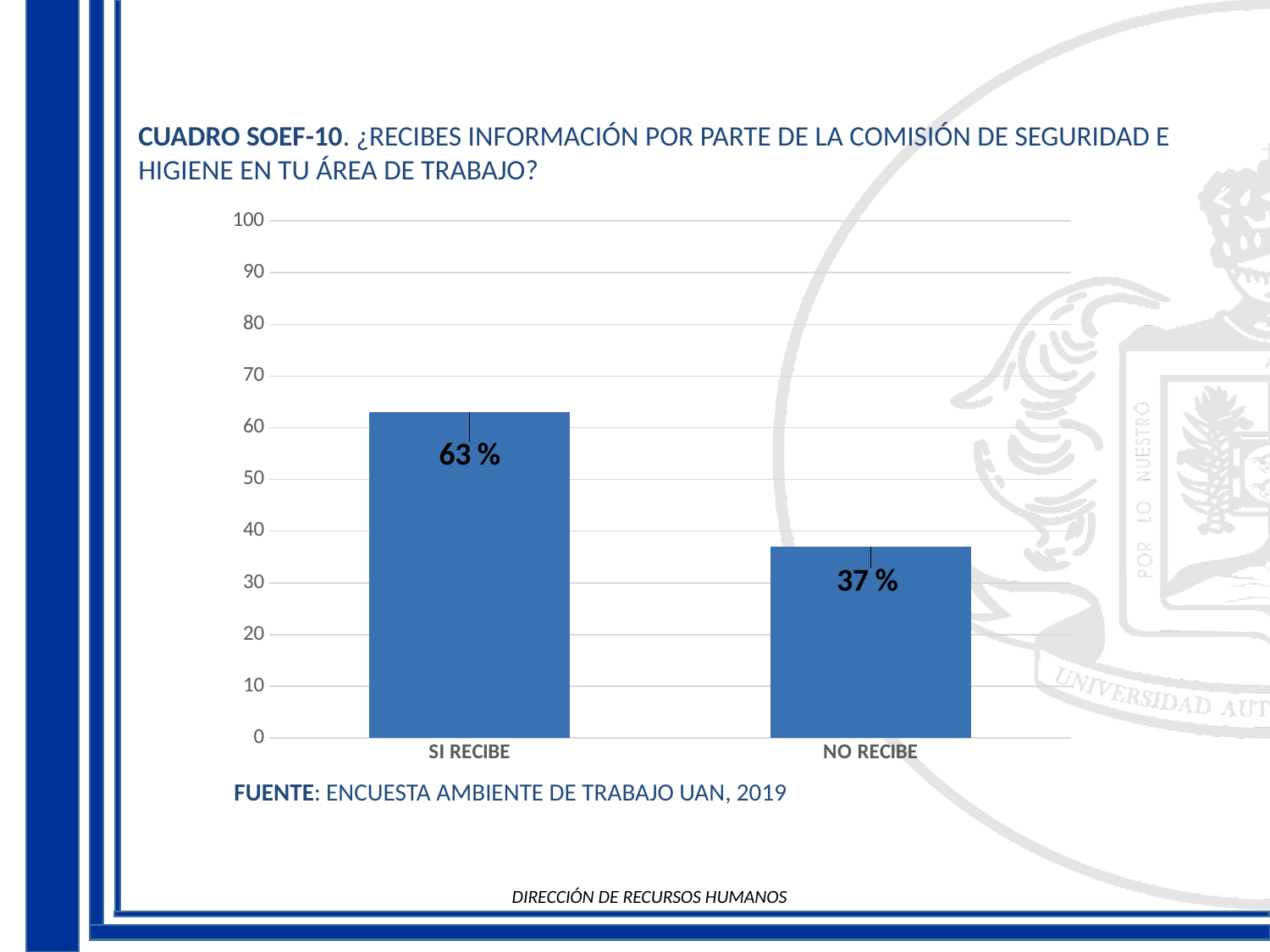
How many categories are shown on the x axis? 2 What is the maximum value shown on the y axis? 100 What is the value for NO RECIBE? 37 % Which category has the lowest value? NO RECIBE What is the difference between the values for SI RECIBE and NO RECIBE? 26 % Is the value for NO RECIBE greater or less than 40? less Is the value for SI RECIBE greater or less than 60? greater Which category has the highest value? SI RECIBE Which is larger, the value for SI RECIBE or the value for NO RECIBE? SI RECIBE What is the value for SI RECIBE? 63 % What kind of chart is shown on the slide? bar chart What is the source cited below the chart? ENCUESTA AMBIENTE DE TRABAJO UAN, 2019